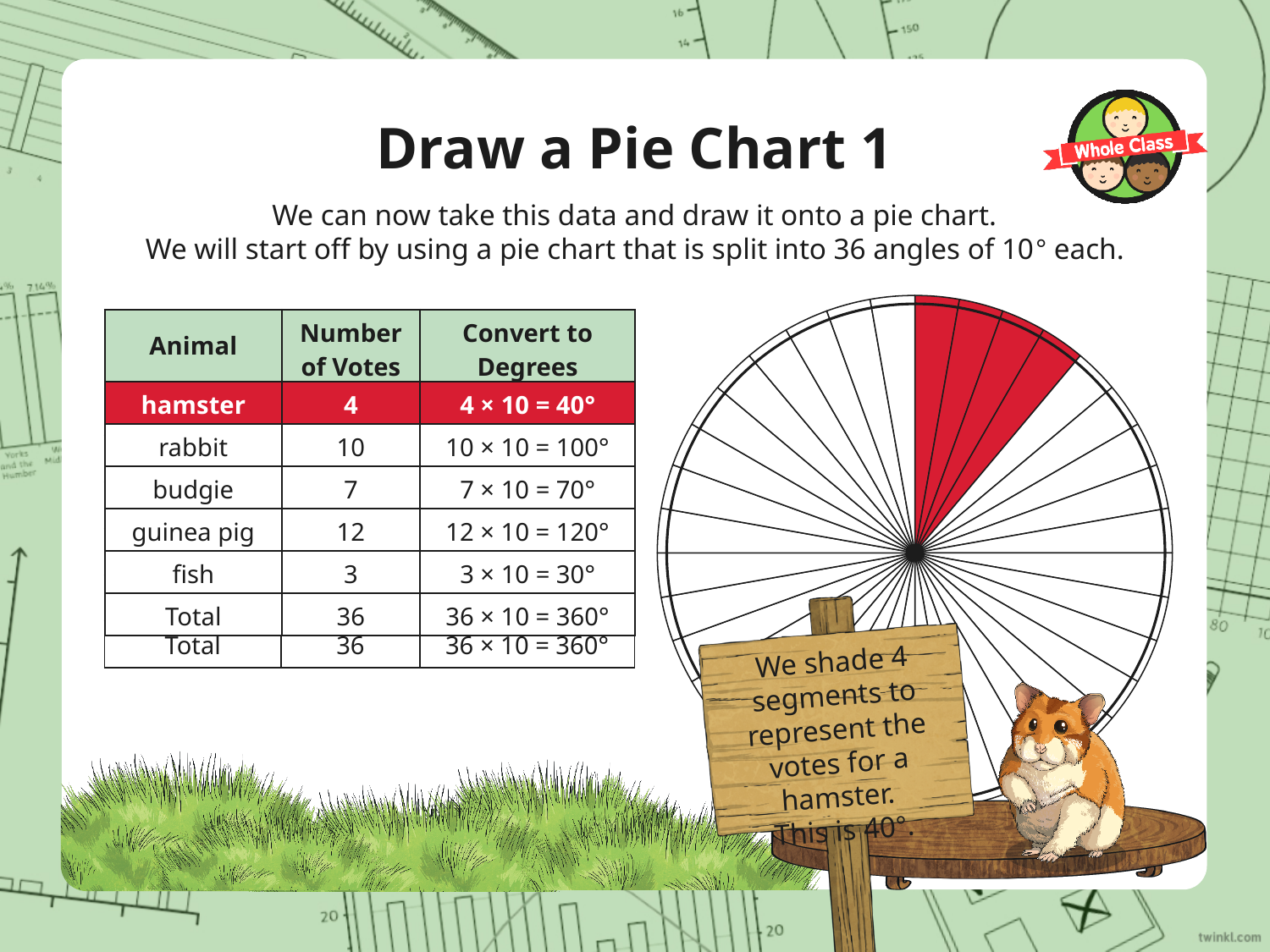
What kind of chart is drawn on the right of the slide? pie chart How many degrees is each segment of the pie chart? 10° How many segments of the pie chart are shaded red? 4 According to the table, how many votes did the hamster receive? 4 What angle does the red shaded section of the pie chart represent? 40° According to the table, which animal received the most votes? guinea pig How many equal segments is the pie chart split into? 36 How many degrees will the guinea pig section of the pie chart be? 120° According to the table, which animal received the fewest votes? fish What is the total number of votes shown in the table? 36 Which animal does the red shaded section of the pie chart represent? hamster What is the difference in degrees between the rabbit section and the budgie section? 30°